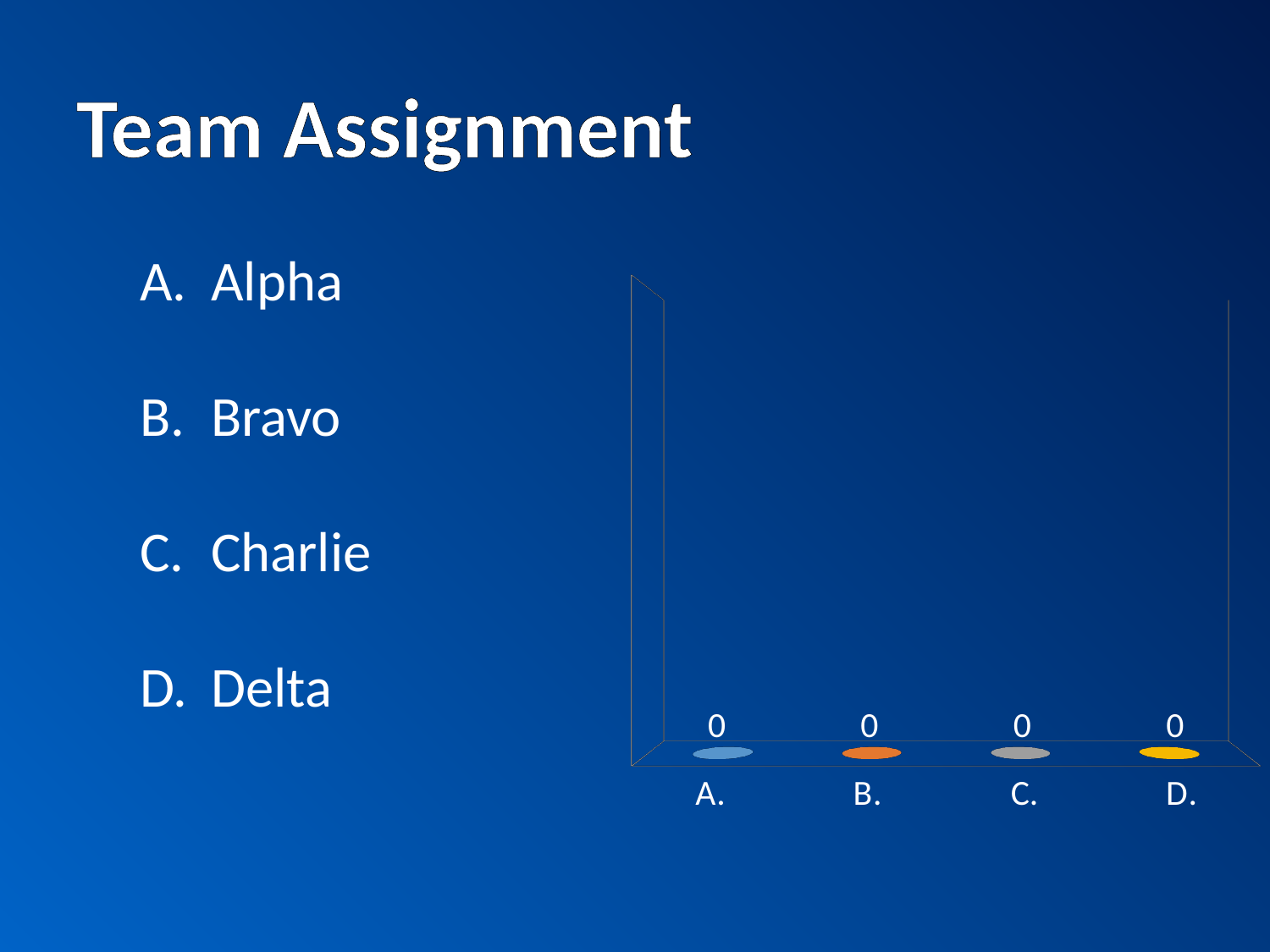
What is the value for category D. in the chart? 0 What is the difference between the values for B. and C.? 0 What colour is the marker for category D. in the chart? yellow What colour is the marker for category B. in the chart? orange What is the value for category C. in the chart? 0 What is the difference between the values for A. and D.? 0 What is the value for category A. in the chart? 0 What is the value for category B. in the chart? 0 What kind of chart is shown on the slide? bar chart Do the values rise, fall, or stay flat from A. to D.? stay flat How many categories are plotted on the x axis of the chart? 4